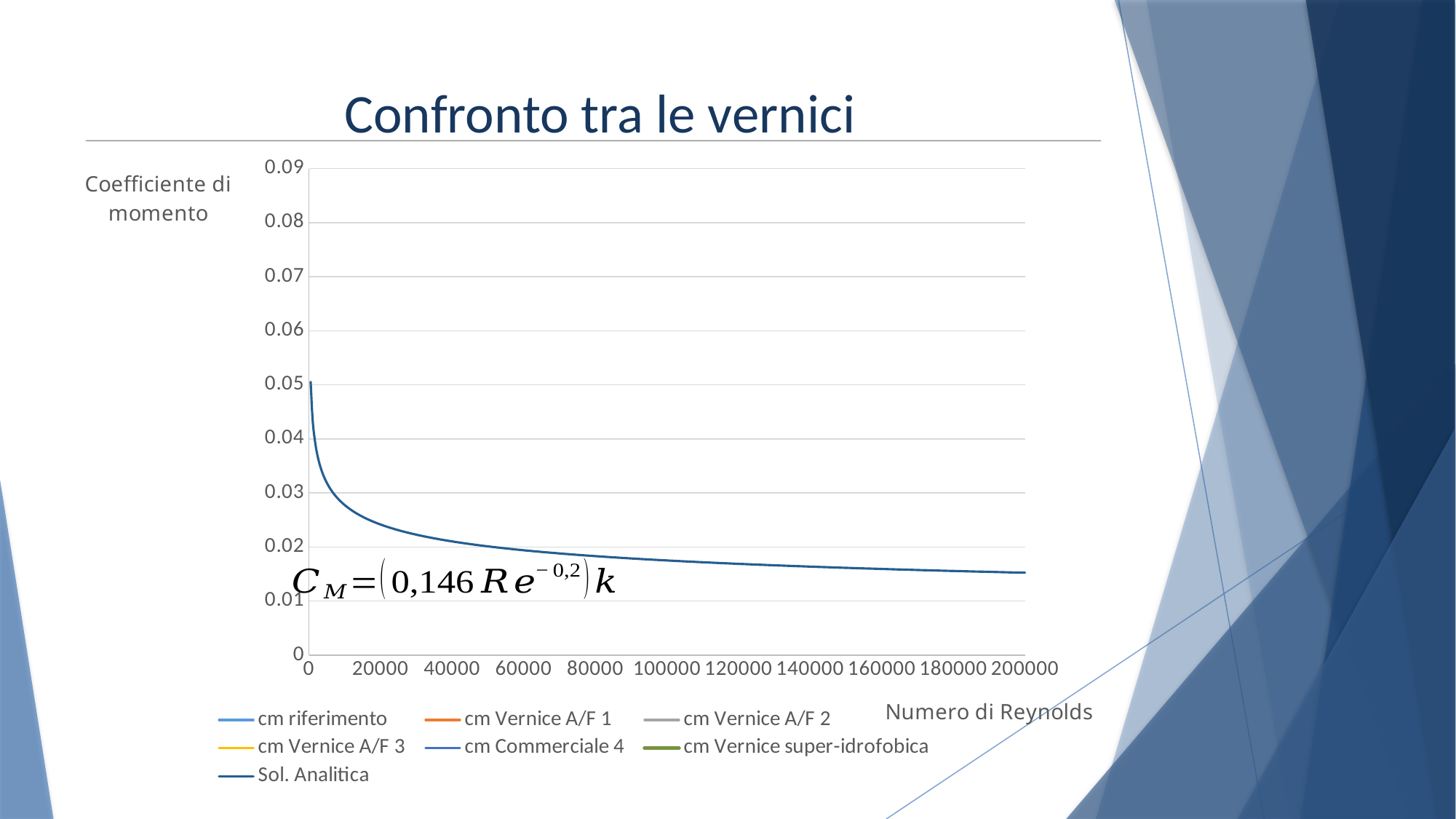
What is the highest value shown on the y axis? 0.09 Is the plotted value at a Reynolds number of 40000 greater or less than 0.03? less Do the plotted values rise or fall as the Reynolds number increases along the x axis? fall Is the plotted value at a Reynolds number of 200000 greater or less than 0.02? less Is the plotted value at a Reynolds number of 20000 greater or less than 0.02? greater What kind of chart is shown on the slide? line chart What is the label of the x axis? Numero di Reynolds How many series does the legend list? 7 What is the title of the chart? Confronto tra le vernici